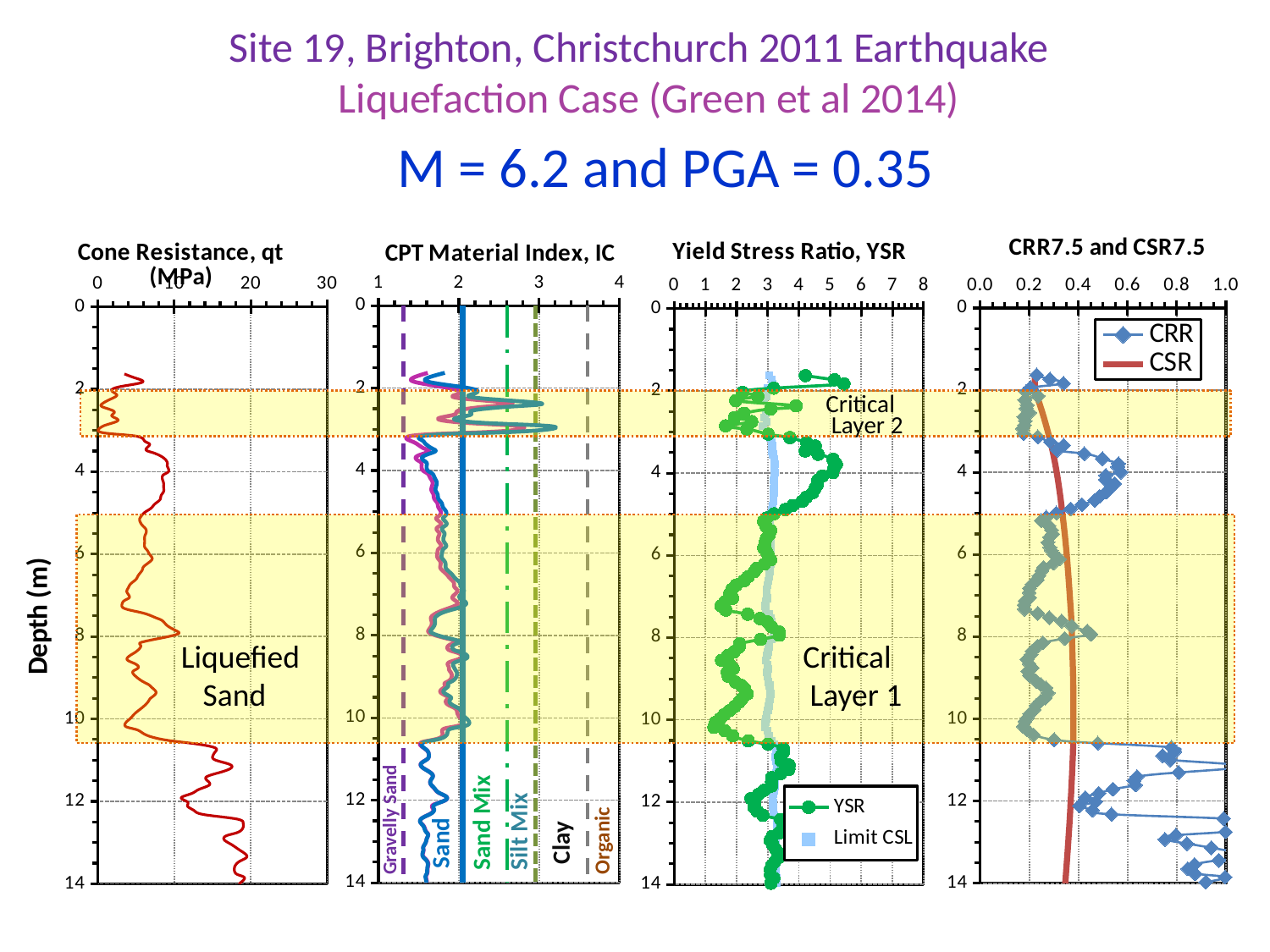
In the Yield Stress Ratio, YSR chart, what are the two legend entries? YSR and Limit CSL In the Yield Stress Ratio, YSR chart, is the YSR value at a depth of 4 m larger or smaller than the YSR value at a depth of 10 m? larger How many charts are shown on the slide? 4 In the Yield Stress Ratio, YSR chart, how many series does the legend list? 2 In the CRR7.5 and CSR7.5 chart, does the CSR line increase or decrease as depth increases from 2 m to 14 m? increase In the Cone Resistance, qt (MPa) chart, is the value at a depth of 6 m greater or less than 10 MPa? less In the Cone Resistance, qt (MPa) chart, is the value at a depth of 14 m greater or less than 10 MPa? greater In the CRR7.5 and CSR7.5 chart, which series has the larger value at a depth of 13 m, CRR or CSR? CRR In the CRR7.5 and CSR7.5 chart, is the CSR value at a depth of 2 m greater or less than 0.4? less In the CRR7.5 and CSR7.5 chart, how many series does the legend list? 2 What kind of chart is the Cone Resistance, qt (MPa) chart? line chart